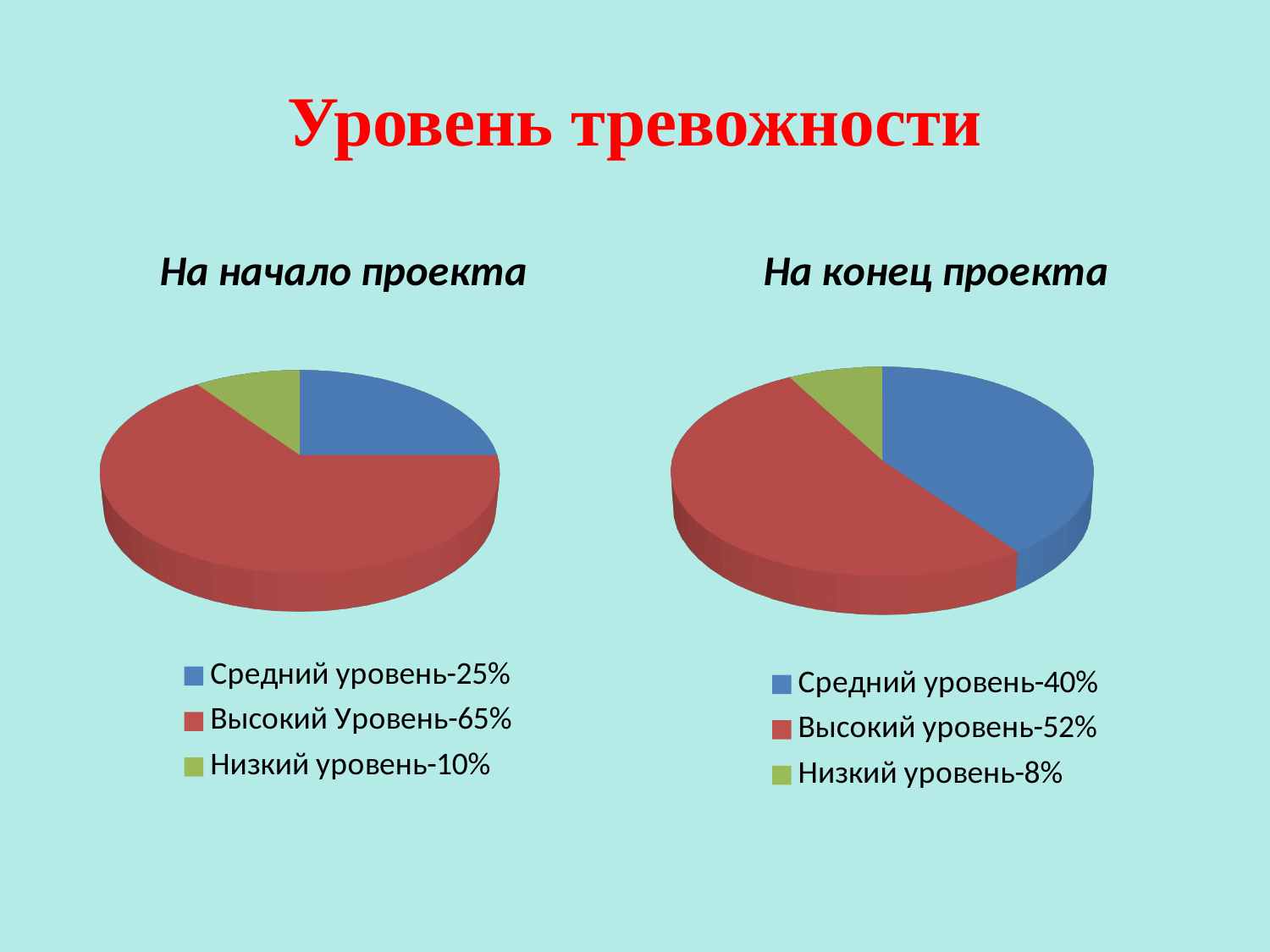
In the "На начало проекта" chart, what is the value for Низкий уровень? 10% How many entries does the legend of the "На начало проекта" chart list? 3 In the "На начало проекта" chart, what is the value for Высокий Уровень? 65% How many slices does the "На конец проекта" pie chart have? 3 In the "На конец проекта" chart, what is the difference between Высокий уровень and Средний уровень? 12% In the "На начало проекта" chart, which category has the largest slice? Высокий Уровень What kind of chart is shown under "На начало проекта"? Pie chart In the "На начало проекта" chart, which is larger: Средний уровень or Низкий уровень? Средний уровень In the "На начало проекта" chart, what colour is the Высокий Уровень slice? Red In the "На конец проекта" chart, which category has the smallest slice? Низкий уровень In the "На конец проекта" chart, what is the value for Низкий уровень? 8% In the "На конец проекта" chart, what is the value for Средний уровень? 40%